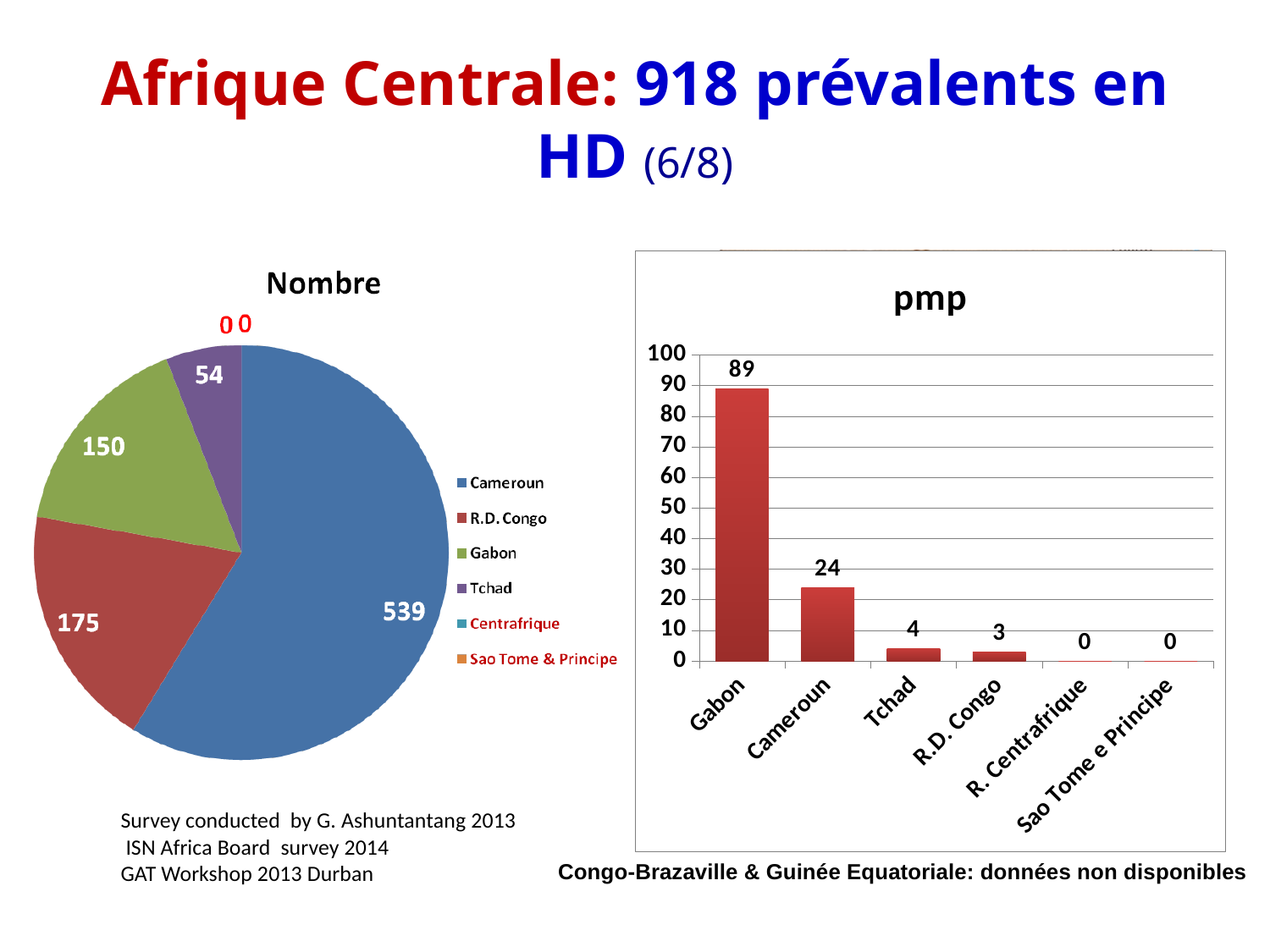
In the bar chart titled "pmp", what is the difference between the values for Gabon and Cameroun? 65 In the pie chart titled "Nombre", which category has the largest slice? Cameroun In the bar chart titled "pmp", what is the value for Tchad? 4 What type of chart is the chart titled "pmp"? Bar chart In the bar chart titled "pmp", which country has the highest value? Gabon In the pie chart titled "Nombre", what share of the total do the 539 for Cameroun represent? 58.7% In the pie chart titled "Nombre", what is the value for R.D. Congo? 175 In the bar chart titled "pmp", what is the value for Gabon? 89 In the pie chart titled "Nombre", what is the value for Cameroun? 539 In the bar chart titled "pmp", which is larger, the value for Cameroun or the value for R.D. Congo? Cameroun In the pie chart titled "Nombre", what is the difference between the values for Gabon and Tchad? 96 In the pie chart titled "Nombre", how many categories does the legend list? 6